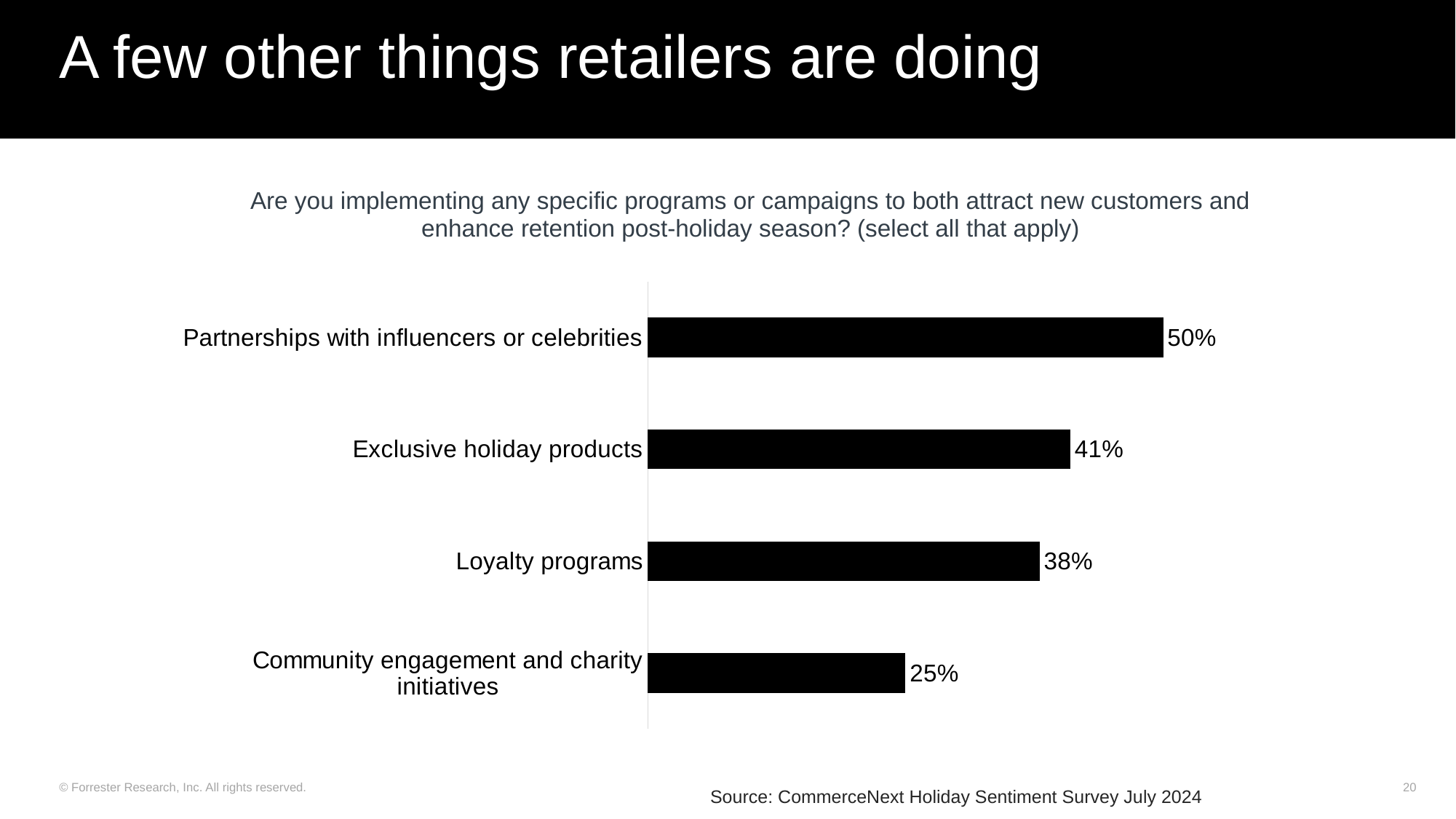
What is the difference in percentage points between Partnerships with influencers or celebrities and Community engagement and charity initiatives? 25 percentage points Which program or campaign has the highest percentage? Partnerships with influencers or celebrities What is the difference between Exclusive holiday products and Loyalty programs? 3 percentage points How many programs or campaigns are shown in the chart? 4 What is the value for Community engagement and charity initiatives? 25% Which program or campaign has the lowest percentage? Community engagement and charity initiatives What kind of chart is shown on the slide? Bar chart What is the value shown for Exclusive holiday products? 41% Which is larger: the value for Exclusive holiday products or the value for Loyalty programs? Exclusive holiday products What percentage of retailers are implementing partnerships with influencers or celebrities? 50% What percentage is shown for Loyalty programs? 38% What is the source cited for the chart data? CommerceNext Holiday Sentiment Survey July 2024